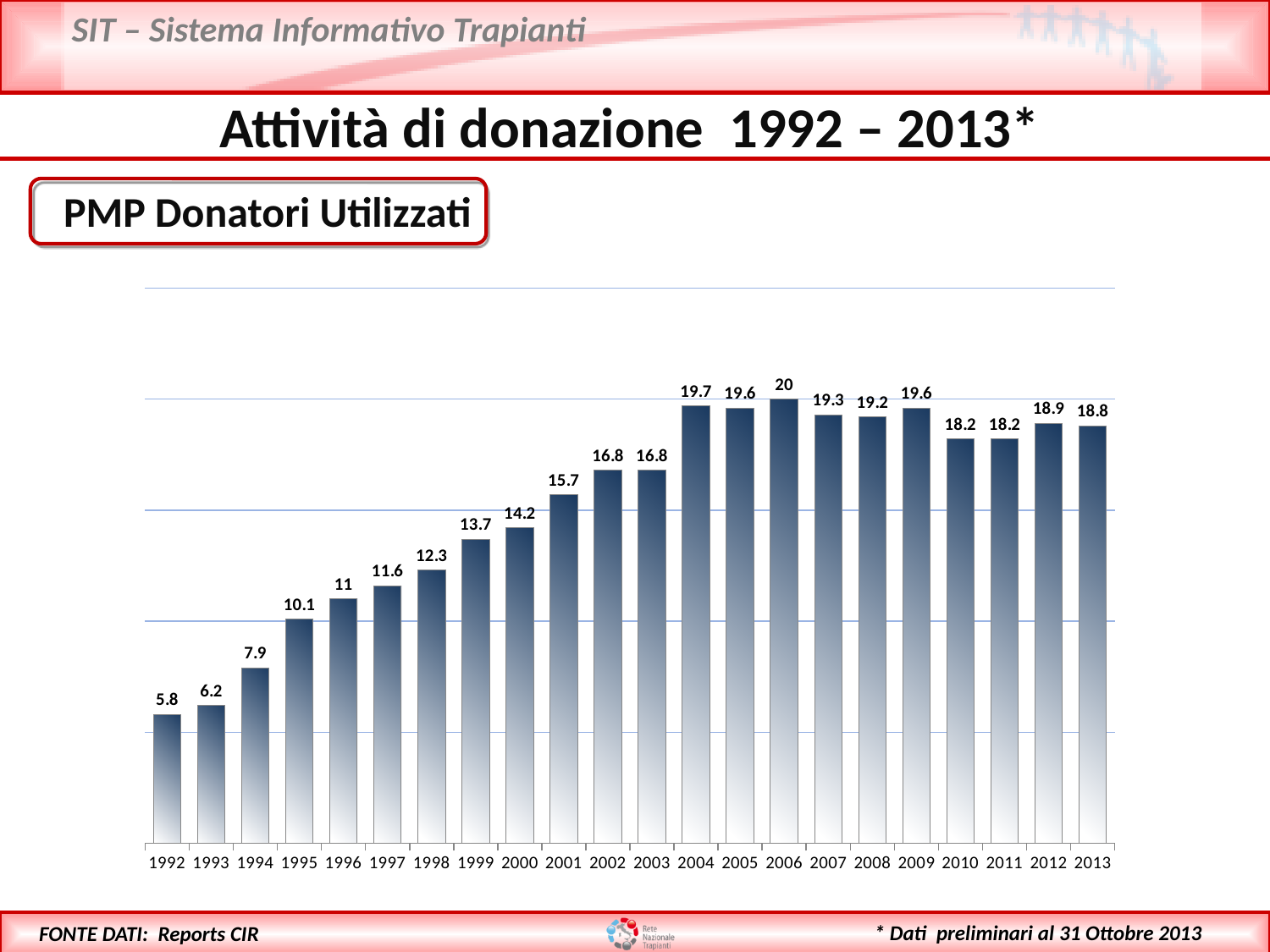
What is the value for 2006? 20 Do the values rise or fall from 1992 to 2006? Rise What is the value for 1992? 5.8 Which is larger, the value for 2012 or the value for 2010? 2012 What is the difference between the values for 2013 and 1992? 13 Which year has the highest value? 2006 How many years are shown on the x axis? 22 What kind of chart is shown on the slide? Bar chart Which year has the lowest value? 1992 What is the value for 2013? 18.8 What is the difference between the values for 2004 and 2003? 2.9 What is the value for 1999? 13.7